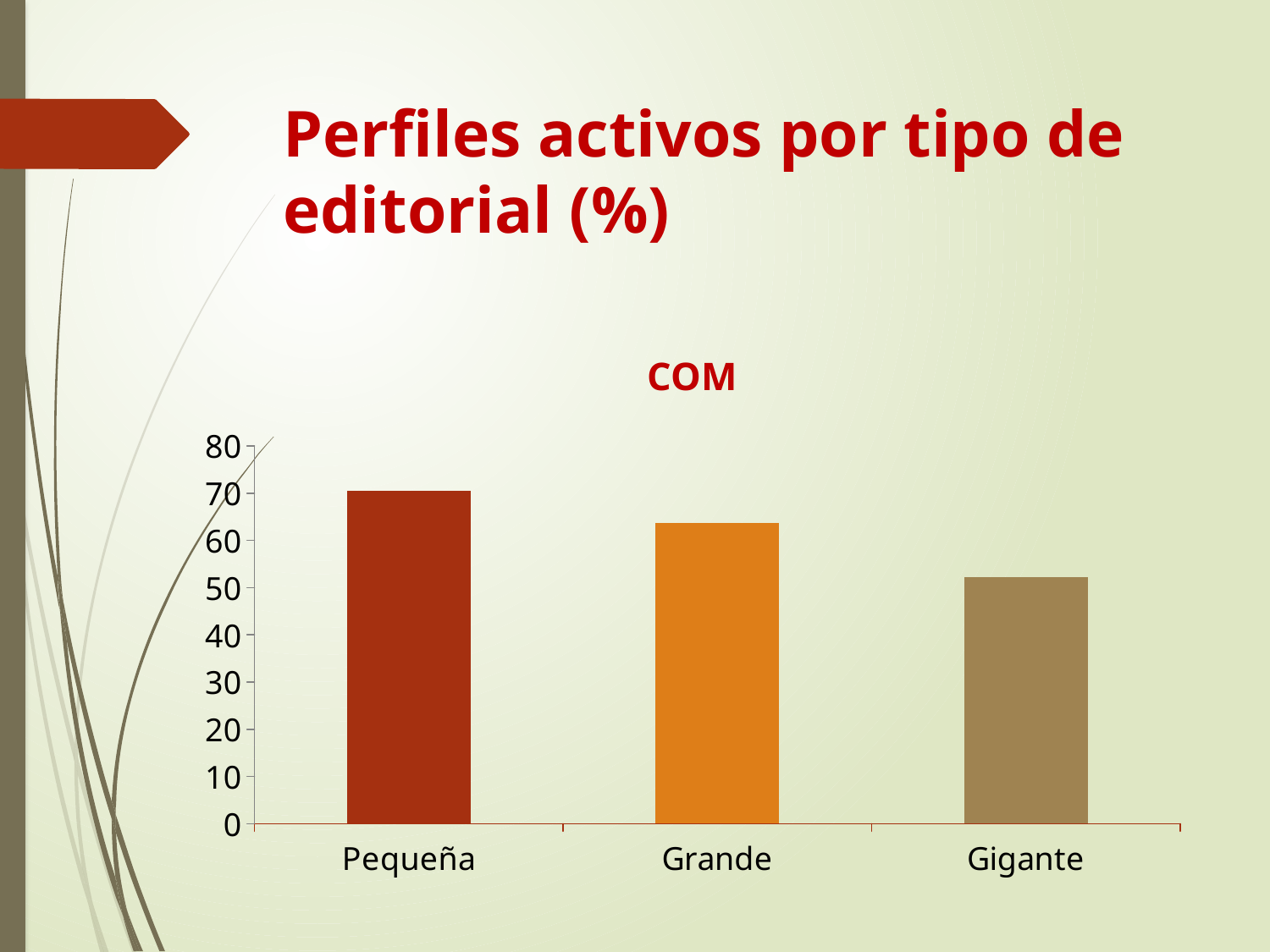
Which is larger, the value for Pequeña or the value for Grande? Pequeña Which category has the lowest bar in the chart? Gigante Which category has the highest bar in the chart? Pequeña Do the bar values rise or fall from Pequeña to Gigante along the x axis? fall Is the value for Gigante greater or less than 60? less How many categories are plotted on the x axis of the chart? 3 What is the title shown above the chart? COM Is the value for Grande greater or less than 70? less Which is larger, the value for Grande or the value for Gigante? Grande What kind of chart is shown on the slide? bar chart Is the value for Pequeña greater or less than 60? greater